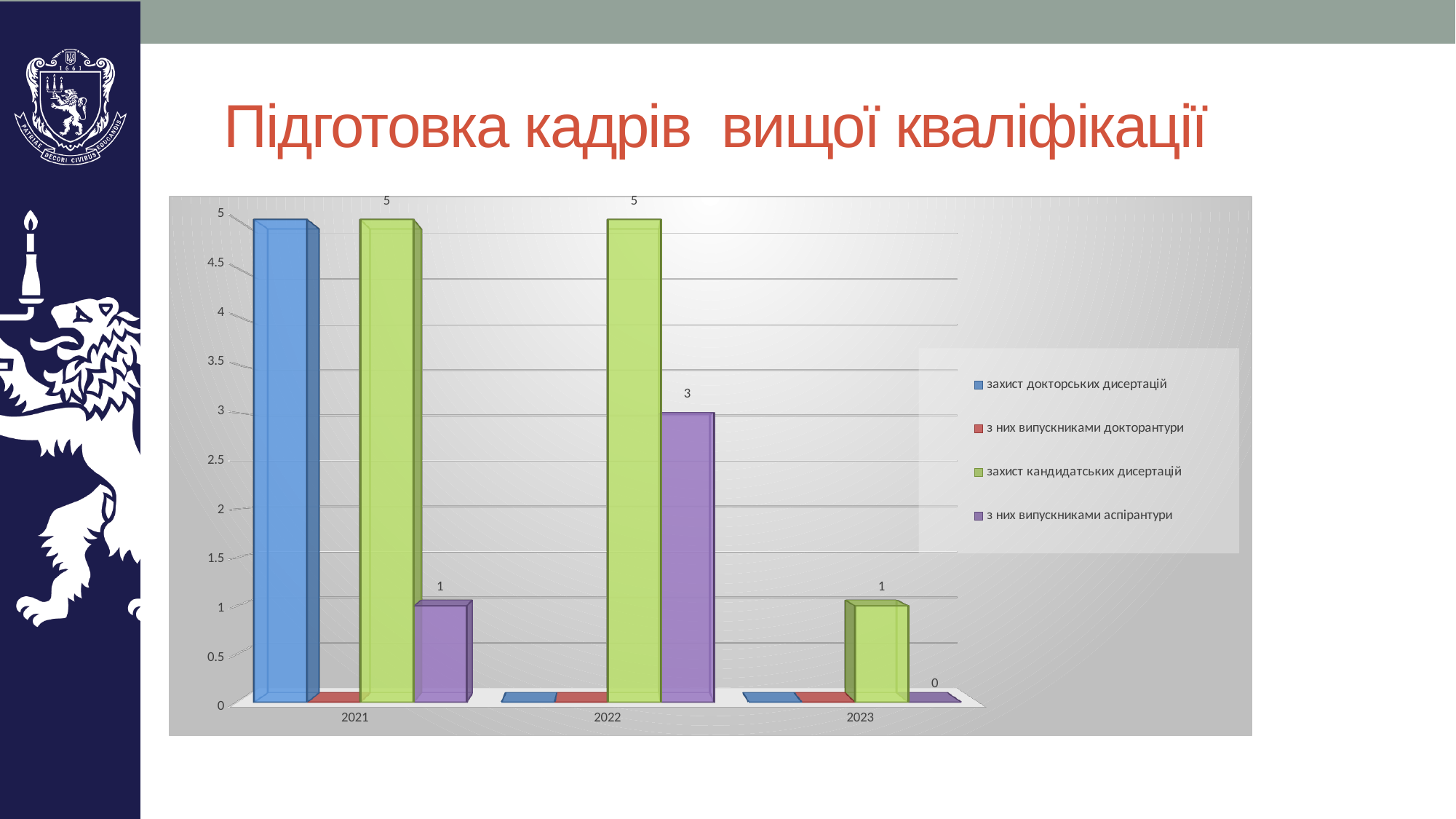
What is the value for з них випускниками аспірантури in 2023? 0 What is the value for захист докторських дисертацій in 2021? 5 What is the difference between захист кандидатських дисертацій and з них випускниками аспірантури in 2022? 2 Which colour represents захист кандидатських дисертацій in the legend? green What kind of chart is shown on the slide? bar chart What is the value for захист кандидатських дисертацій in 2021? 5 How many years are shown on the x axis? 3 What is the value for з них випускниками аспірантури in 2022? 3 What is the value for з них випускниками аспірантури in 2021? 1 What is the value for захист кандидатських дисертацій in 2023? 1 In which year is the value for з них випускниками аспірантури highest? 2022 How many series does the legend list? 4